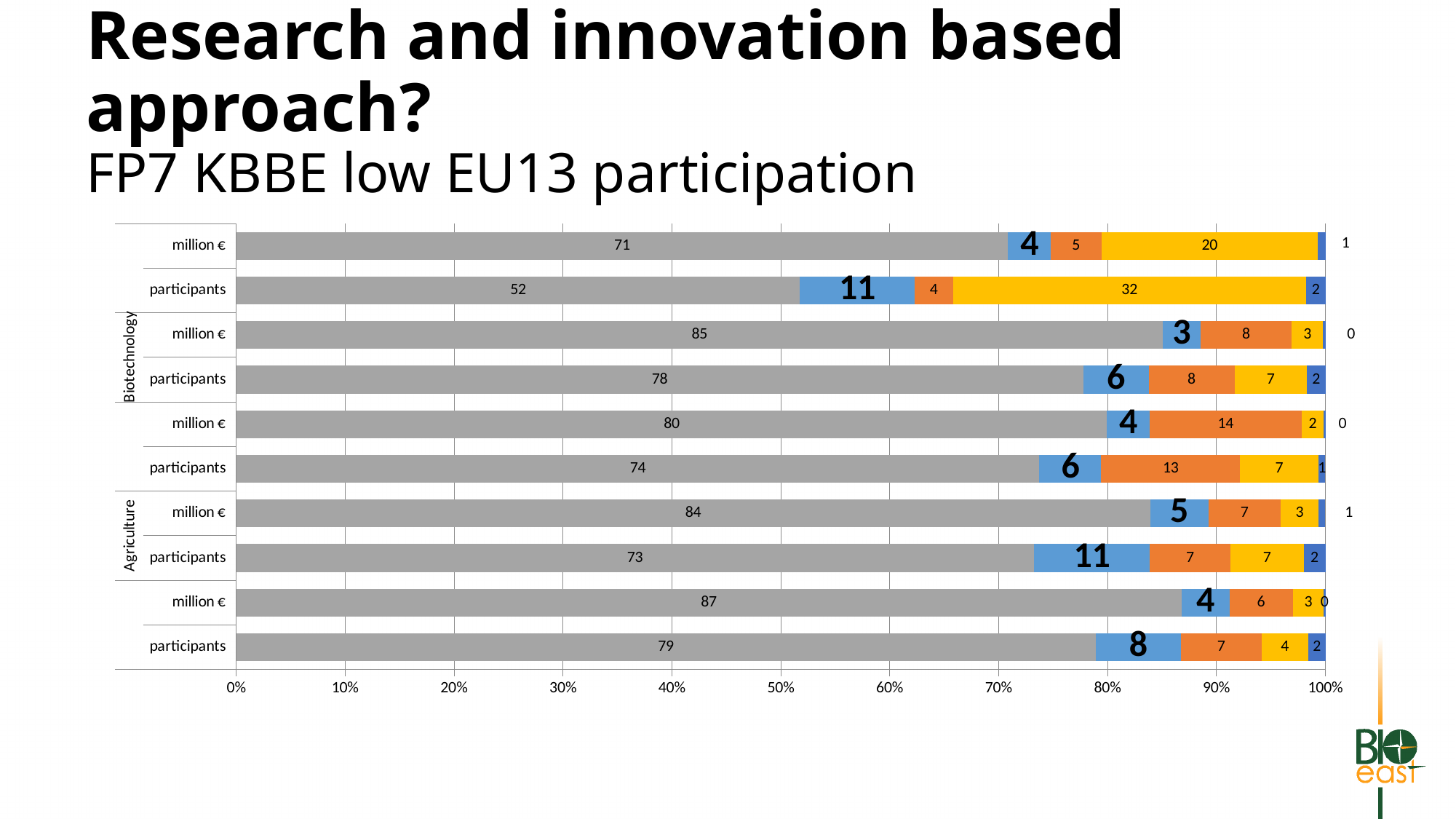
What is the value of the grey segment in the top bar (million €)? 71 What is the difference between the grey segments of the Agriculture million € bar (84) and the Agriculture participants bar (73)? 11 What is the value of the grey segment in the Agriculture million € bar? 84 Which has the larger grey segment: the Agriculture million € bar or the Agriculture participants bar? Agriculture million € How many bars are plotted in the chart? 10 Which bar has the smallest grey segment? The participants bar second from the top (52) What kind of chart is shown on the slide? Stacked bar chart What is the value of the blue segment in the Agriculture participants bar? 11 Is the grey segment of the second bar from the top (participants) greater or less than 50%? greater Which bar has the largest grey segment? The million € bar second from the bottom (87) What is the value of the yellow segment in the second bar from the top (participants)? 32 What is the value of the grey segment in the bottom bar (participants)? 79